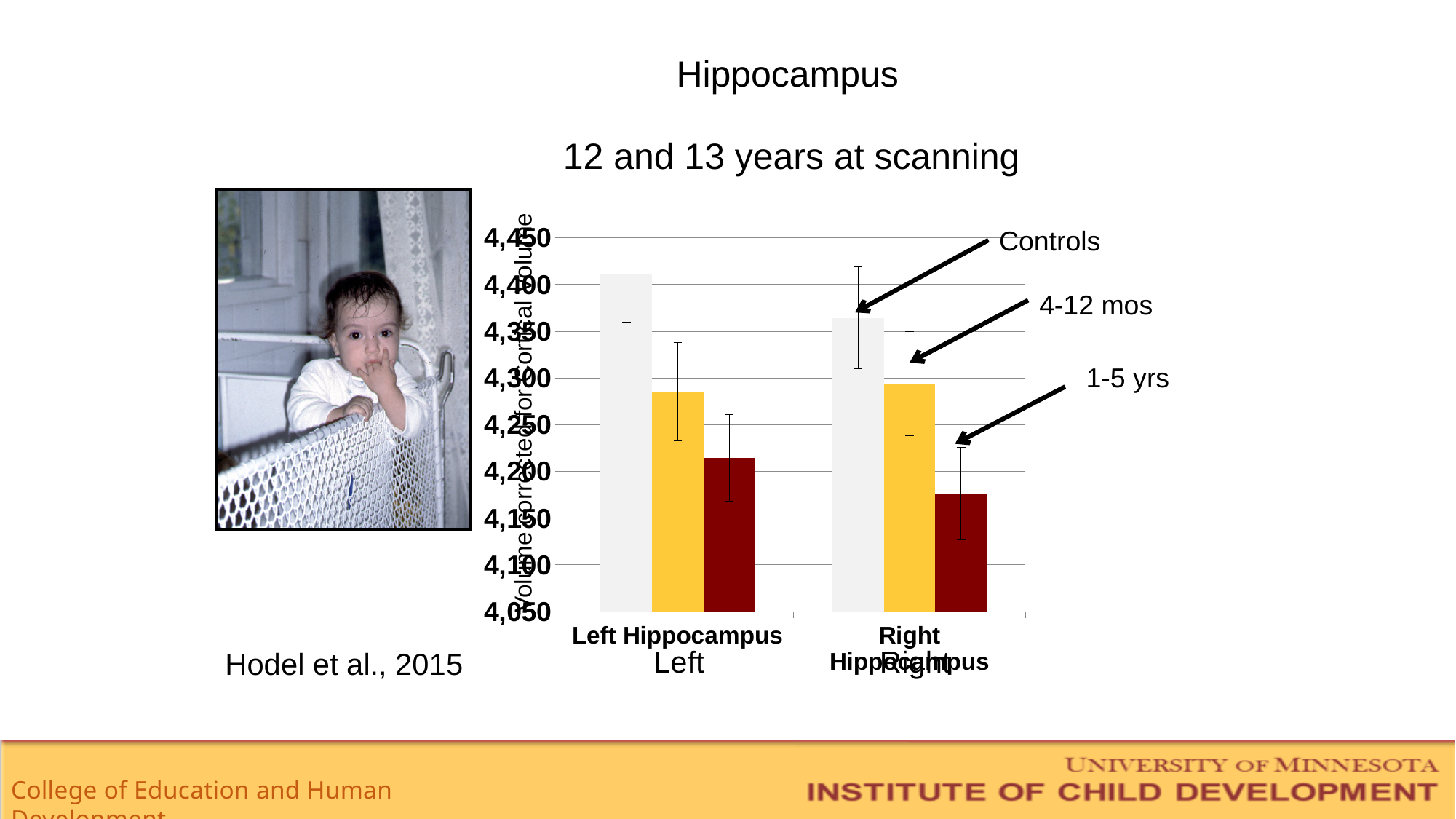
Is the Controls value for Left Hippocampus greater or less than 4,400? greater Which bar is the tallest in the whole chart? Controls, Left Hippocampus Is the Controls value larger for Left Hippocampus or Right Hippocampus? Left Hippocampus Which group has the highest bar in the Left Hippocampus category? Controls Is the 4-12 mos value for Left Hippocampus greater or less than 4,300? less Is the 1-5 yrs value for Right Hippocampus greater or less than 4,200? less What colour are the bars for the 1-5 yrs group? dark red How many groups (series) are labelled on the chart? 3 What kind of chart is shown on the slide? bar chart Which group has the lowest bar in the Right Hippocampus category? 1-5 yrs How many categories are shown on the x axis of the chart? 2